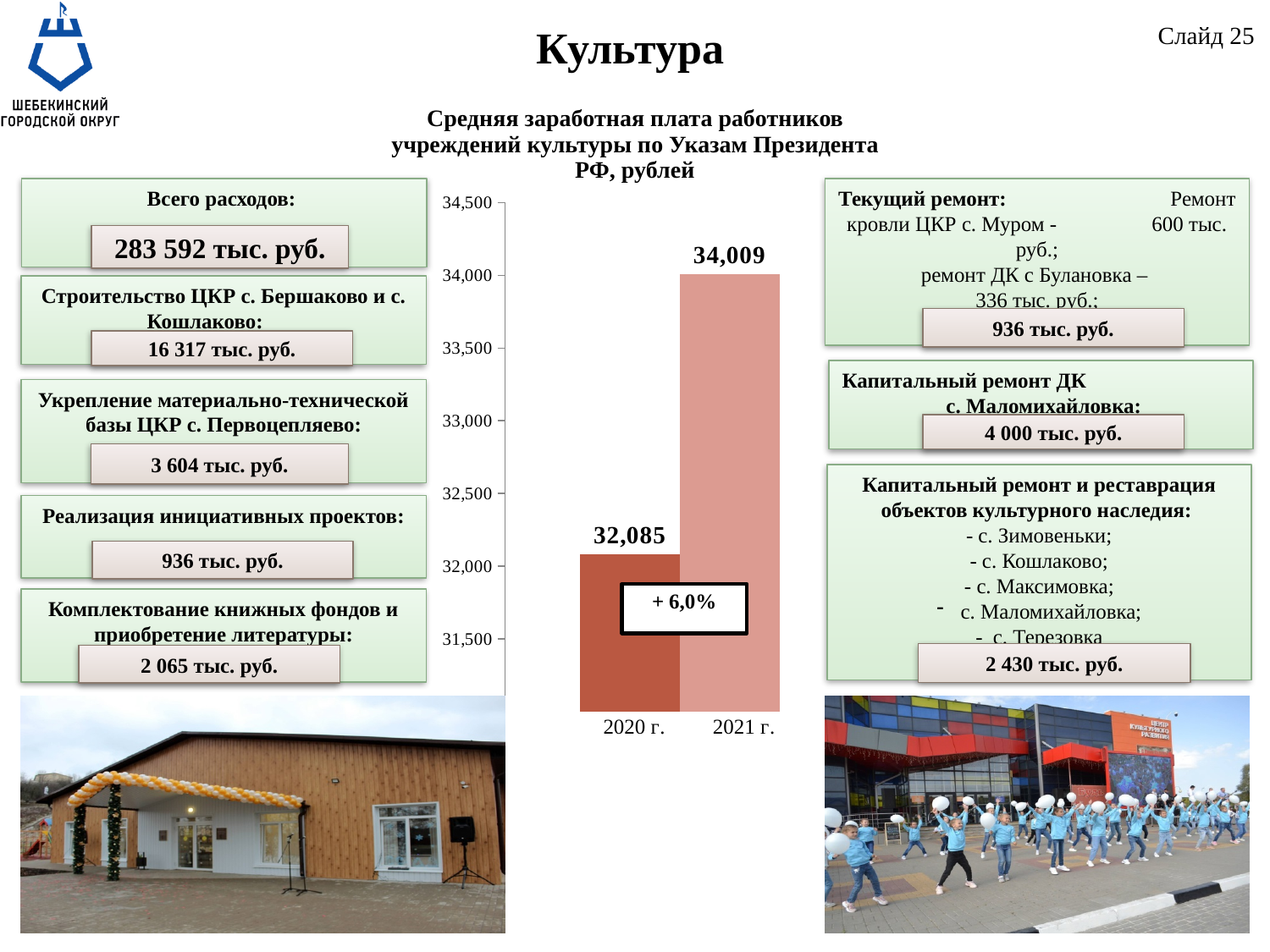
What is the value for 2020 г. in the chart? 32,085 Which year has the lower value in the chart? 2020 г. What type of chart is shown on the slide? bar chart What is the value for 2021 г. in the chart? 34,009 Is the value for 2020 г. greater or less than 32,500? less Do the values rise or fall from 2020 г. to 2021 г.? rise What percentage change is printed on the chart between the two bars? + 6,0% Is the value for 2020 г. larger or smaller than the value for 2021 г.? smaller What is the difference between the 2021 г. and 2020 г. values in the chart? 1,924 Is the value for 2021 г. greater or less than 34,000? greater Which year has the higher value in the chart? 2021 г. How many bars are shown in the chart? 2